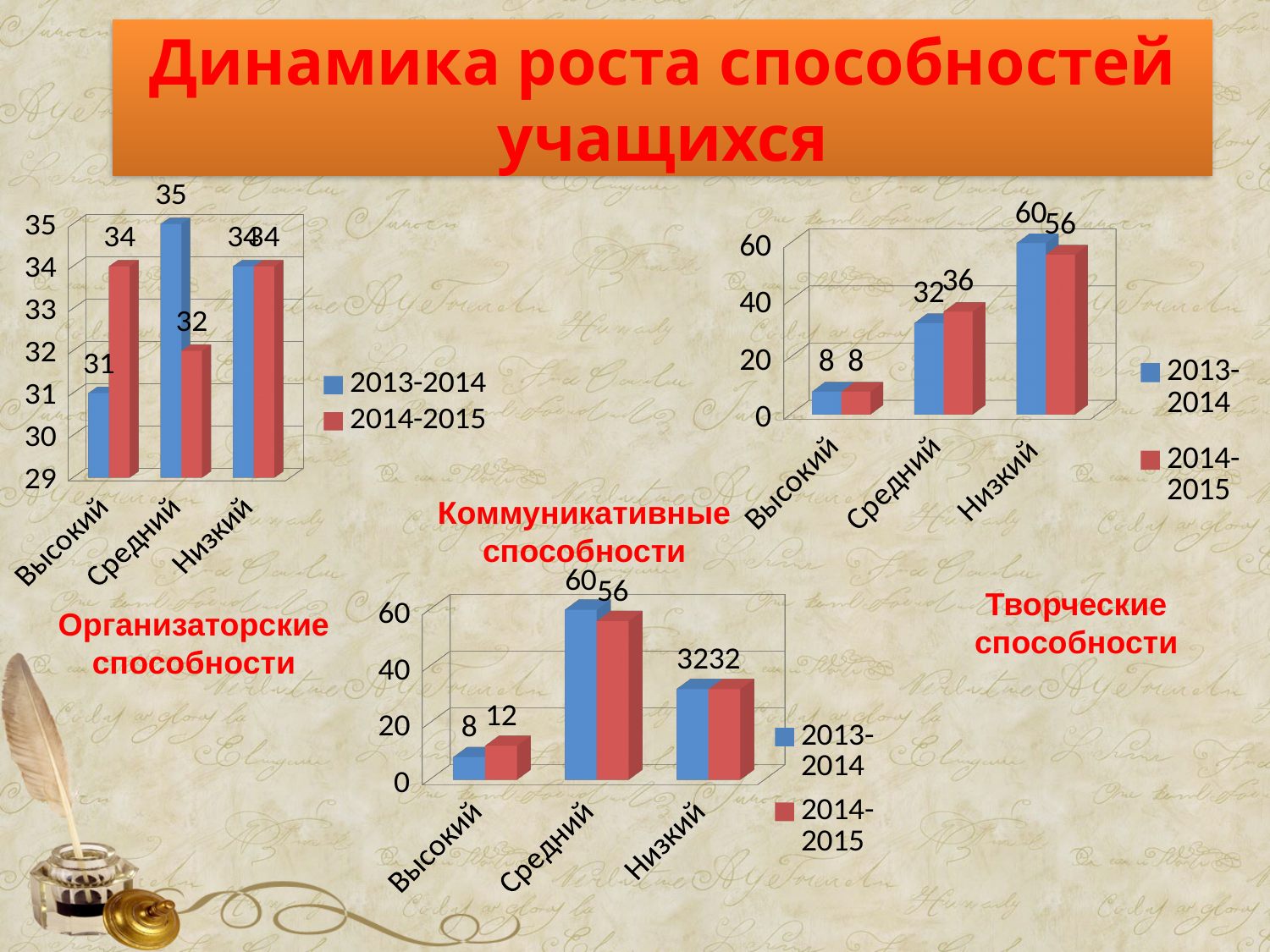
In the 'Организаторские способности' chart, which category has the highest value for 2013-2014? Средний In the 'Организаторские способности' chart, what is the value for Высокий in 2013-2014? 31 What type of chart is the 'Коммуникативные способности' chart? Bar chart In the 'Творческие способности' chart, what is the difference between the 2013-2014 and 2014-2015 values for Низкий? 4 In the 'Творческие способности' chart, what is the value for Средний in 2014-2015? 36 In the 'Творческие способности' chart, which category has the highest value for 2014-2015? Низкий In the 'Организаторские способности' chart, what is the value for Средний in 2014-2015? 32 In the 'Коммуникативные способности' chart, which category has the lowest value for 2013-2014? Высокий In the 'Организаторские способности' chart, what is the difference between the 2013-2014 and 2014-2015 values for Высокий? 3 How many series does the legend of the 'Творческие способности' chart list? 2 In the 'Коммуникативные способности' chart, which is larger for Средний: the 2013-2014 value or the 2014-2015 value? 2013-2014 In the 'Коммуникативные способности' chart, what is the value for Высокий in 2014-2015? 12